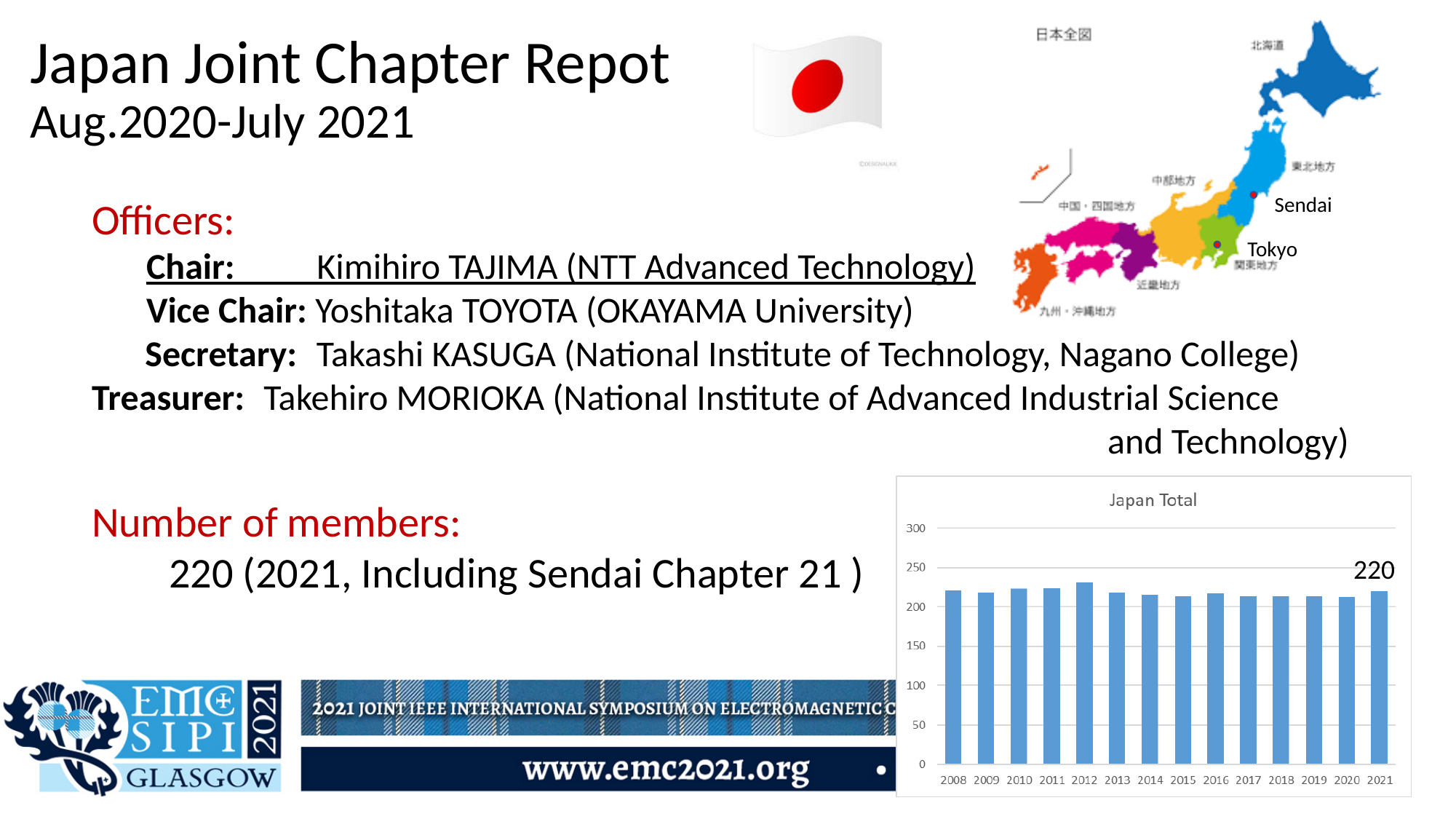
What is the highest value shown on the y axis of the Japan Total chart? 300 What is the value for 2021 in the Japan Total chart? 220 In the Japan Total chart, which is larger, the value for 2012 or the value for 2020? 2012 What is the title of the chart on the slide? Japan Total How many years are shown on the x axis of the Japan Total chart? 14 What is the first year shown on the x axis of the Japan Total chart? 2008 What kind of chart is the Japan Total chart? bar chart Is the value for 2015 in the Japan Total chart greater or less than 150? greater Is the value for 2021 in the Japan Total chart greater or less than 250? less Is the value for 2008 in the Japan Total chart greater or less than 200? greater Which year has the highest bar in the Japan Total chart? 2012